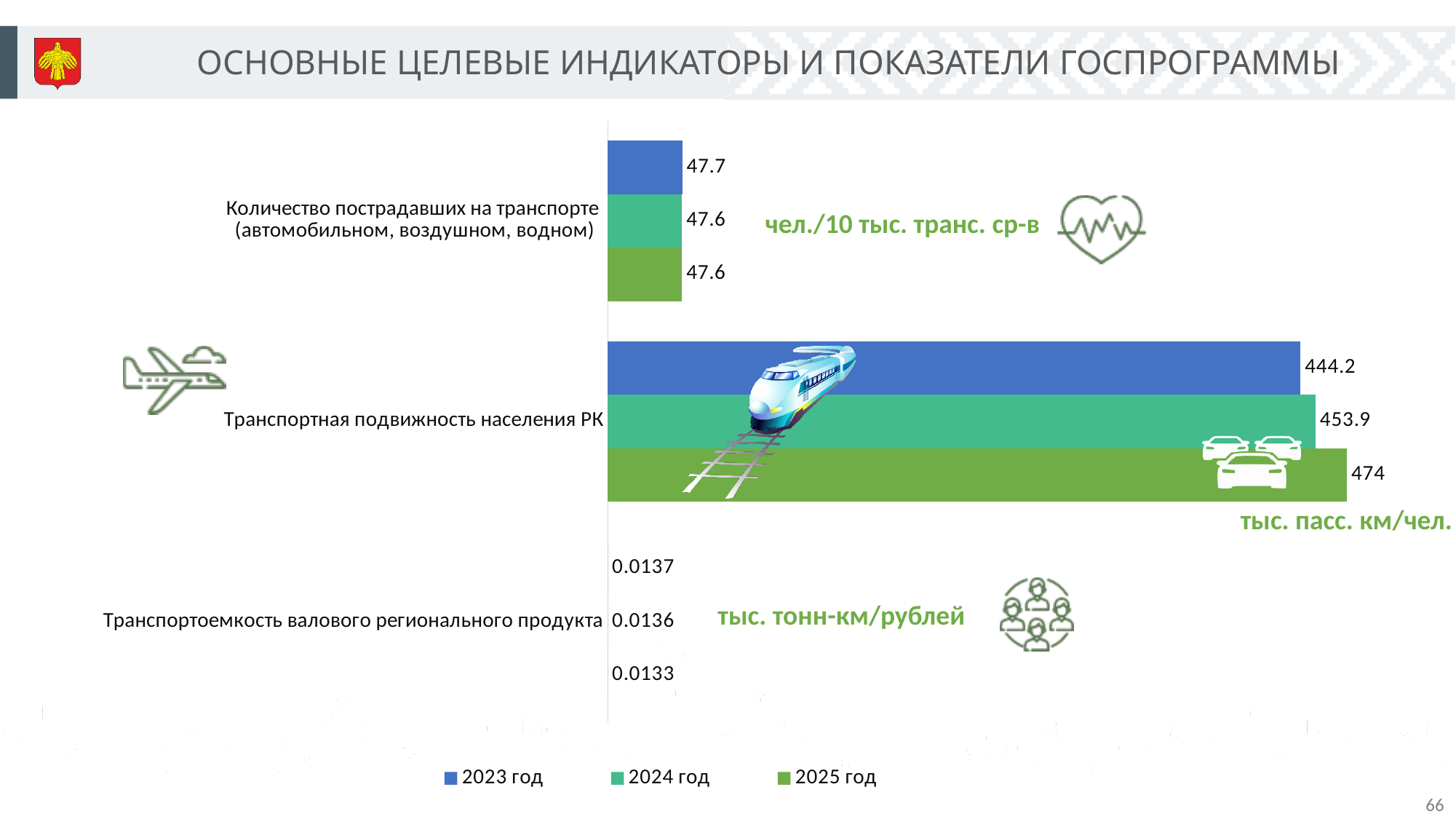
Which series is shown in blue in the legend? 2023 год What is the value for 'Транспортоемкость валового регионального продукта' in 2024 год? 0.0136 How many series does the legend list? 3 What is the value for 'Транспортная подвижность населения РК' in 2023 год? 444.2 What is the value for 'Транспортная подвижность населения РК' in 2025 год? 474 What is the difference between the 2025 год and 2023 год values for 'Транспортная подвижность населения РК'? 29.8 What is the value for 'Количество пострадавших на транспорте (автомобильном, воздушном, водном)' in 2023 год? 47.7 Which year has the highest value for 'Транспортная подвижность населения РК'? 2025 год Which year has the lowest value for 'Транспортоемкость валового регионального продукта'? 2025 год Does the value for 'Транспортная подвижность населения РК' rise or fall from 2023 год to 2025 год? rise What kind of chart is shown on the slide? bar chart How many categories (indicators) are plotted on the chart? 3